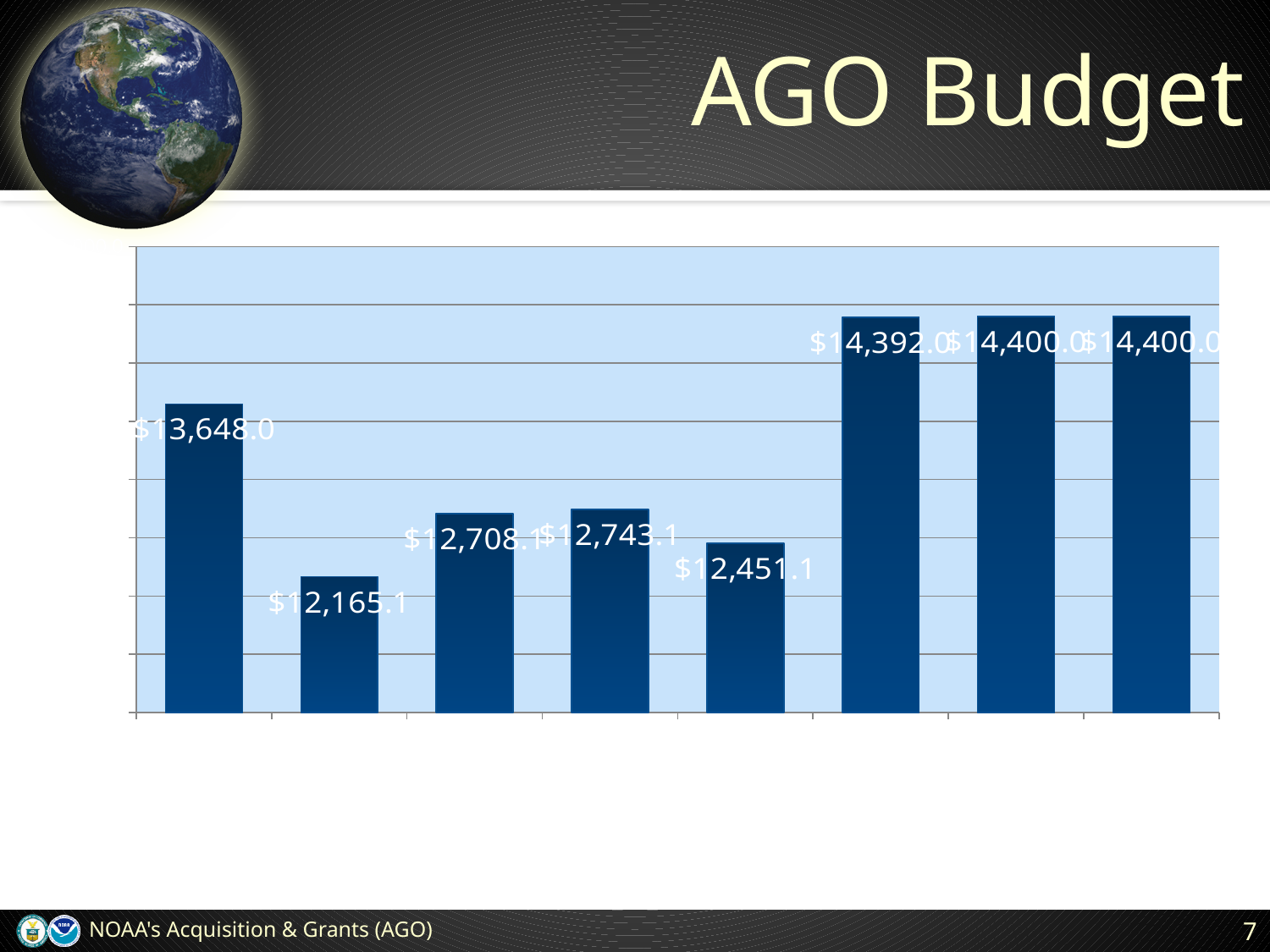
What is the value shown on the second bar from the left? $12,165.1 Which is larger, the third bar ($12,708.1) or the fourth bar ($12,743.1)? The fourth bar ($12,743.1) What is the difference between the first bar ($13,648.0) and the second bar ($12,165.1)? $1,482.9 What is the highest value shown in the chart? $14,400.0 How many bars are plotted in the chart? 8 What is the value shown on the first (leftmost) bar? $13,648.0 What kind of chart is shown on the slide? Bar chart What is the value shown on the fifth bar from the left? $12,451.1 What is the difference between the seventh bar ($14,400.0) and the sixth bar ($14,392.0)? $8.0 What is the value shown on the sixth bar from the left? $14,392.0 What is the lowest value shown in the chart? $12,165.1 What is the title of the slide containing the chart? AGO Budget